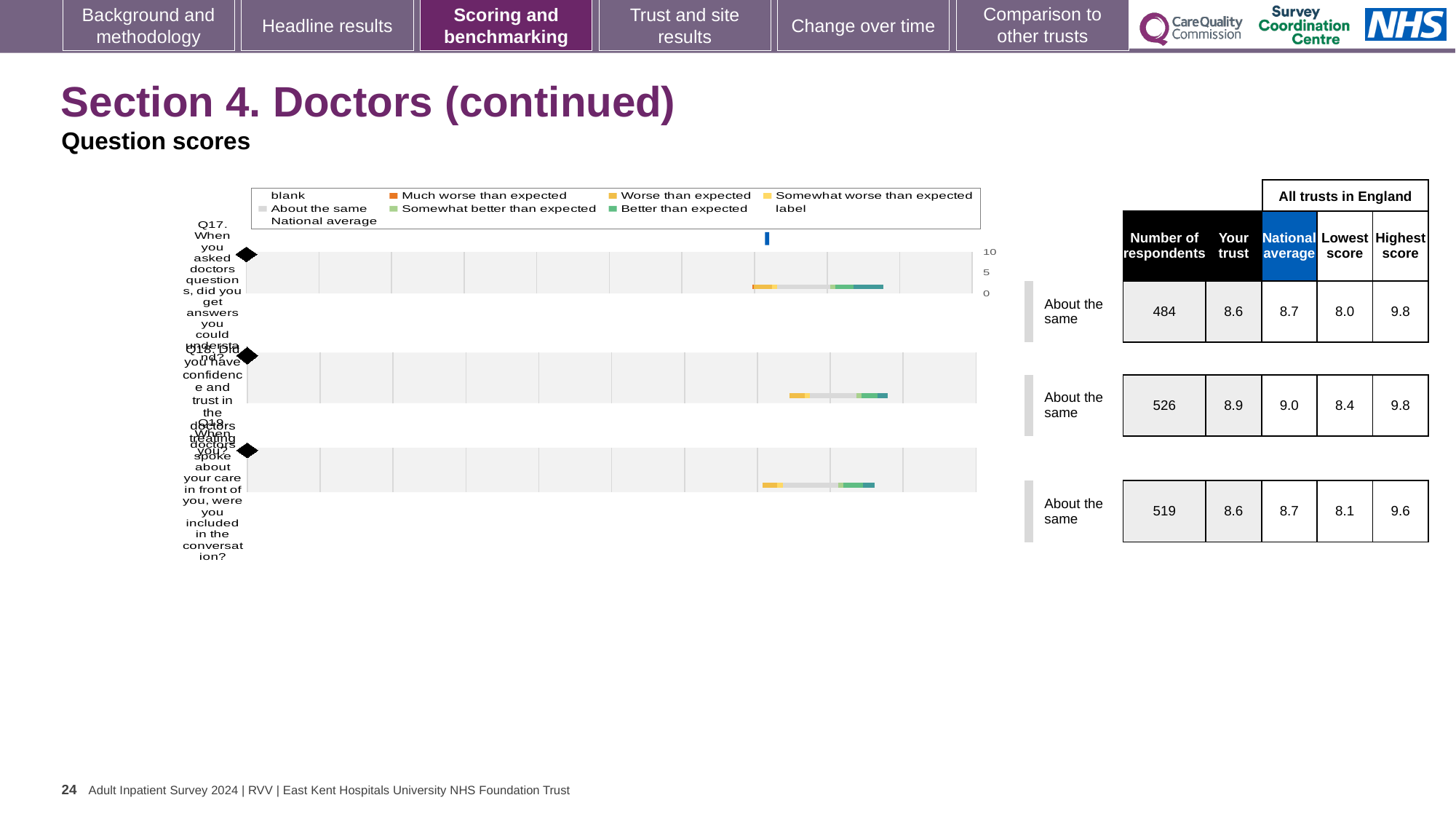
How many questions are plotted in the chart? 3 What is the highest score among all trusts in England for Q19? 9.6 For Q17, which is larger: the 'Your trust' score or the national average? National average Is the trust's score for Q17 greater or less than 5 on the chart axis? greater How many respondents answered Q18? 526 What is the 'Your trust' score for Q18 (Did you have confidence and trust in the doctors treating you)? 8.9 Which benchmark category is shown next to Q18? About the same What is the difference between the national average and the 'Your trust' score for Q18? 0.1 What kind of chart is used to show the question scores for Q17 to Q19? bar chart What is the 'Your trust' score for Q17 (When you asked doctors questions, did you get answers you could understand)? 8.6 What is the national average for Q19 (When doctors spoke about your care in front of you, were you included in the conversation)? 8.7 Which question has the highest 'Your trust' score? Q18